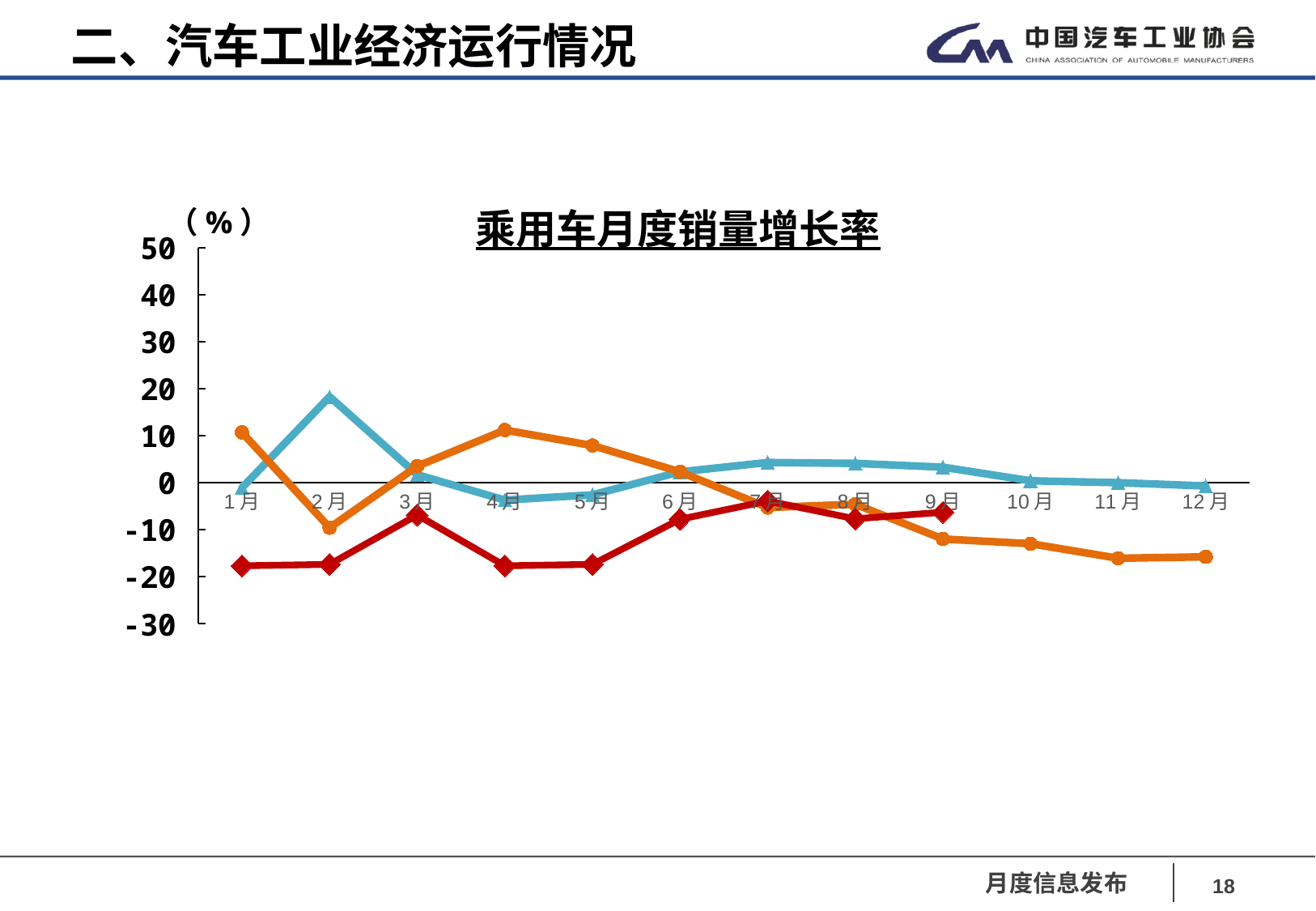
In which month does the blue line reach its highest value? 2月 Is the value of the red line in 1月 greater or less than -10? less Is the value of the blue line in 2月 greater or less than 10? greater Is the value of the blue line in 7月 greater or less than 0? greater Does the orange line rise or fall from 4月 to 12月? fall How many months are shown on the x axis of the chart? 12 What kind of chart is shown on the slide? line chart In 4月, which line has the larger value, the orange line or the blue line? the orange line In 2月, which line has the larger value, the blue line or the orange line? the blue line What is the title of the chart? 乘用车月度销量增长率 How many lines are plotted on the chart? 3